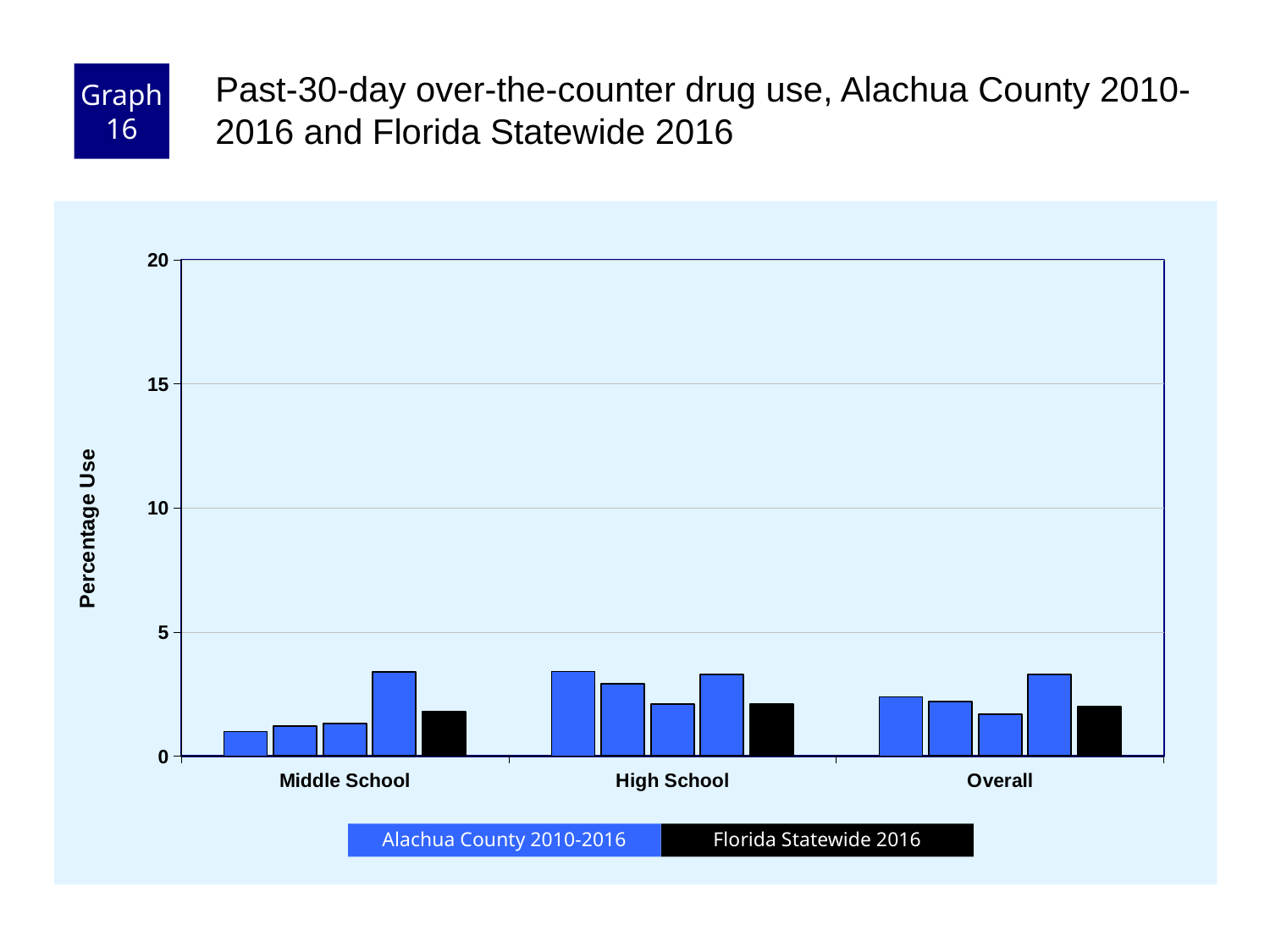
What kind of chart is shown on the slide? bar chart In the Middle School group, which is larger: the Florida Statewide 2016 bar or the tallest Alachua County 2010-2016 bar? the tallest Alachua County 2010-2016 bar Is the value for Florida Statewide 2016 in the High School group greater or less than 5? less What is the label on the y axis? Percentage Use How many series does the legend list? 2 Is the value for Florida Statewide 2016 in the Middle School group greater or less than 5? less How many categories are shown on the x axis? 3 Are any of the Alachua County 2010-2016 bars greater than 5? no Which is larger: the leftmost Alachua County 2010-2016 bar in the Middle School group or the leftmost Alachua County 2010-2016 bar in the High School group? the leftmost Alachua County 2010-2016 bar in the High School group What is the highest value shown on the y axis? 20 Which colour represents Florida Statewide 2016 in the legend? black